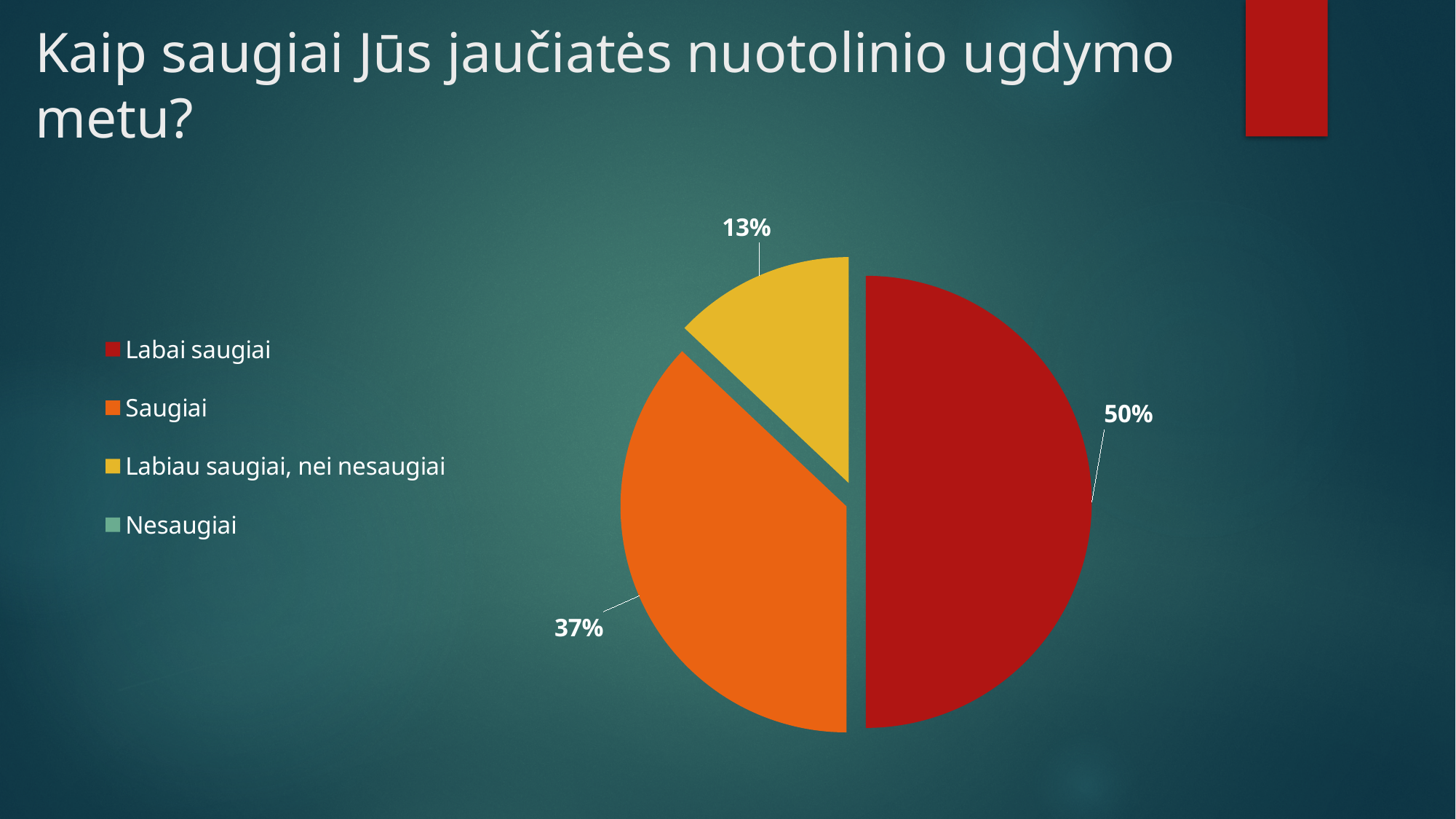
What colour is the "Labai saugiai" slice? red Which slice is larger, "Saugiai" or "Labiau saugiai, nei nesaugiai"? Saugiai What kind of chart is shown on the slide? pie chart What share of the pie is labelled for "Labai saugiai"? 50% How many entries does the legend list? 4 Which category has the largest slice of the pie? Labai saugiai What share of the pie is labelled for "Saugiai"? 37% What share of the pie is labelled for "Labiau saugiai, nei nesaugiai"? 13% What is the title of the slide containing the chart? Kaip saugiai Jūs jaučiatės nuotolinio ugdymo metu? Which of the labelled slices is the smallest? Labiau saugiai, nei nesaugiai What is the difference in percentage points between the "Labai saugiai" slice and the "Saugiai" slice? 13 What is the difference in percentage points between the "Saugiai" slice and the "Labiau saugiai, nei nesaugiai" slice? 24